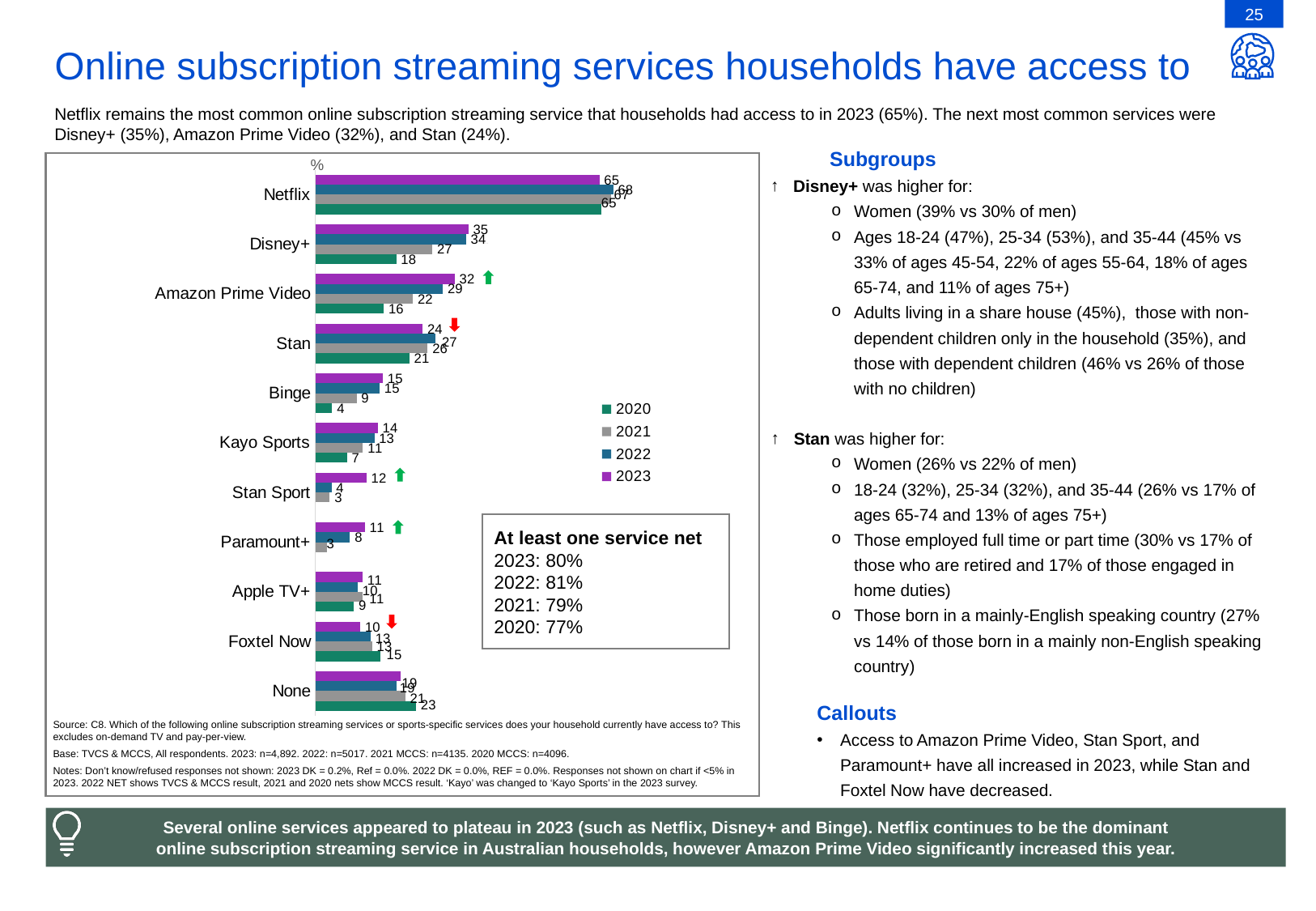
What is the 2020 value for Amazon Prime Video? 16 Which service has the highest 2023 value? Netflix How many categories are shown on the chart? 11 What is the difference between the 2023 and 2020 values for Disney+? 17 Which colour represents 2023 in the chart? Purple How many series does the legend list? 4 What is the 2023 value for Disney+? 35 Which is larger for Foxtel Now, the 2023 value or the 2020 value? 2020 What kind of chart is shown on the slide? Bar chart Which category has the lowest 2020 value? Binge What is the 2023 value for Stan Sport? 12 What is the 2023 value for Netflix? 65